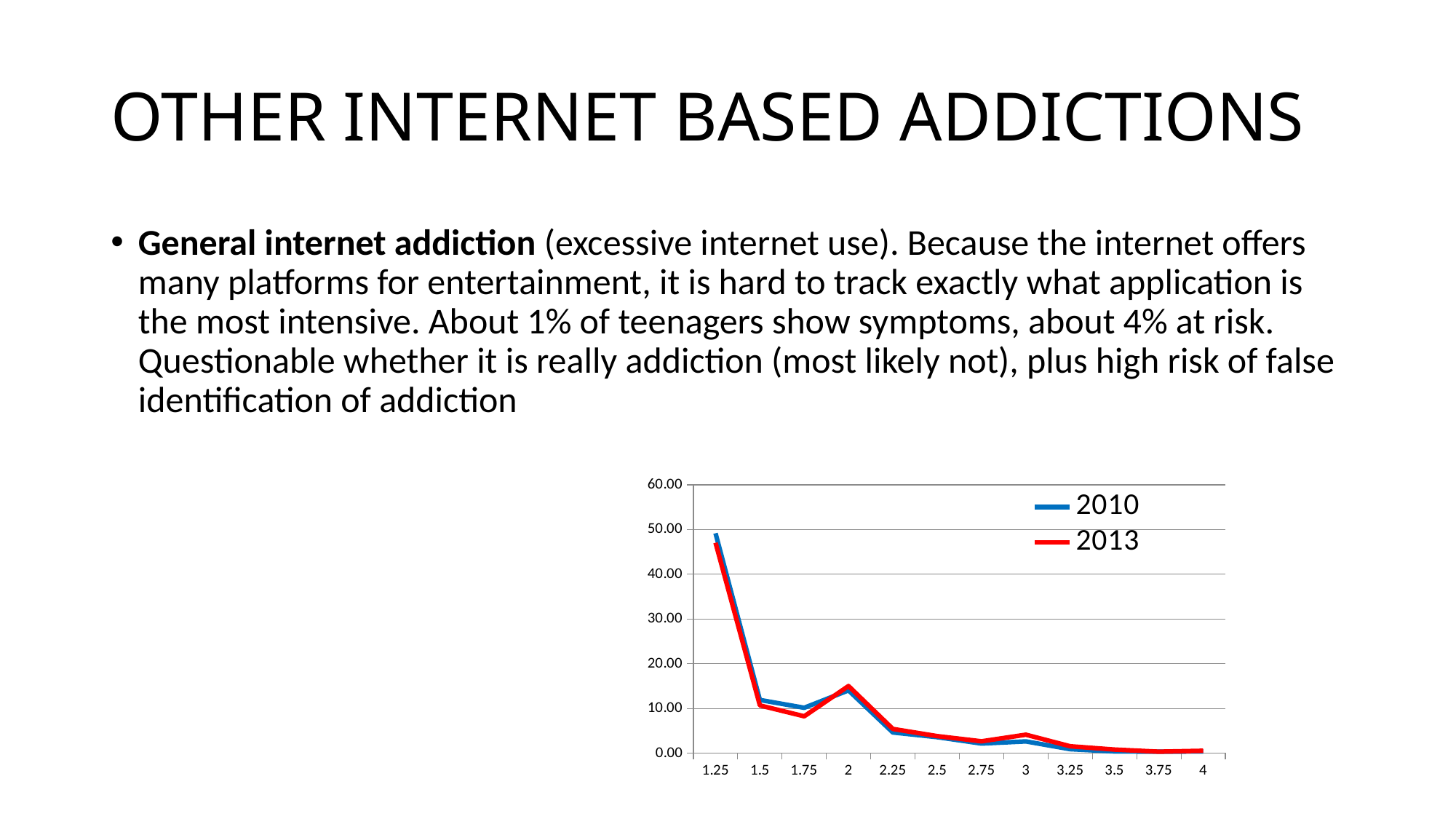
Is the value for the 2013 series at 2 greater or less than 20.00? less Is the value for the 2010 series at 1.25 greater or less than 40.00? greater At which x-axis category does the 2013 series reach its highest value? 1.25 How many series does the chart's legend list? 2 At which x-axis category does the 2010 series reach its highest value? 1.25 How many points are plotted along the x axis of the chart? 12 Is the value for the 2013 series at 1.75 greater or less than 10.00? less Do the values of the 2010 series generally rise or fall from 1.25 to 4 along the x axis? fall Which series are listed in the chart's legend? 2010 and 2013 At x-axis category 1.75, which series has the larger value, 2010 or 2013? 2010 What colour is the line for the 2013 series? red What kind of chart is shown on the slide? line chart